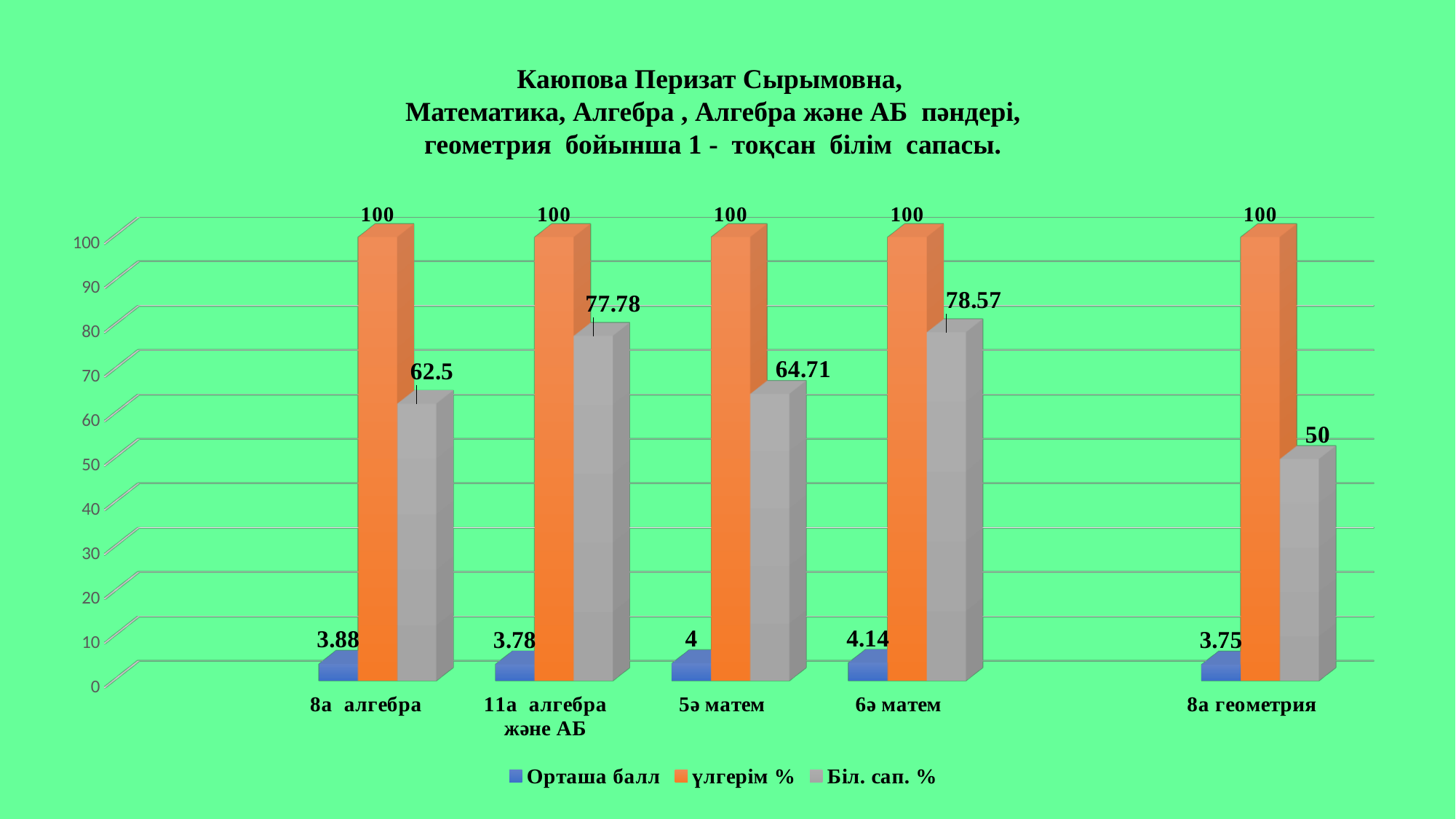
What is the Біл. сап. % value for 11а алгебра және АБ? 77.78 What is the difference between the Біл. сап. % values for 6ә матем and 8а геометрия? 28.57 How many series does the legend list? 3 What kind of chart is shown on the slide? Bar chart What is the үлгерім % value for 8а геометрия? 100 Which category has the lowest Орташа балл value? 8а геометрия Which series is shown in orange in the legend? үлгерім % Which category has the highest Біл. сап. % value? 6ә матем How many categories are shown on the x axis? 5 Which is larger, the Біл. сап. % value for 5ә матем or for 8а алгебра? 5ә матем What is the Біл. сап. % value for 8а алгебра? 62.5 What is the Орташа балл value for 6ә матем? 4.14